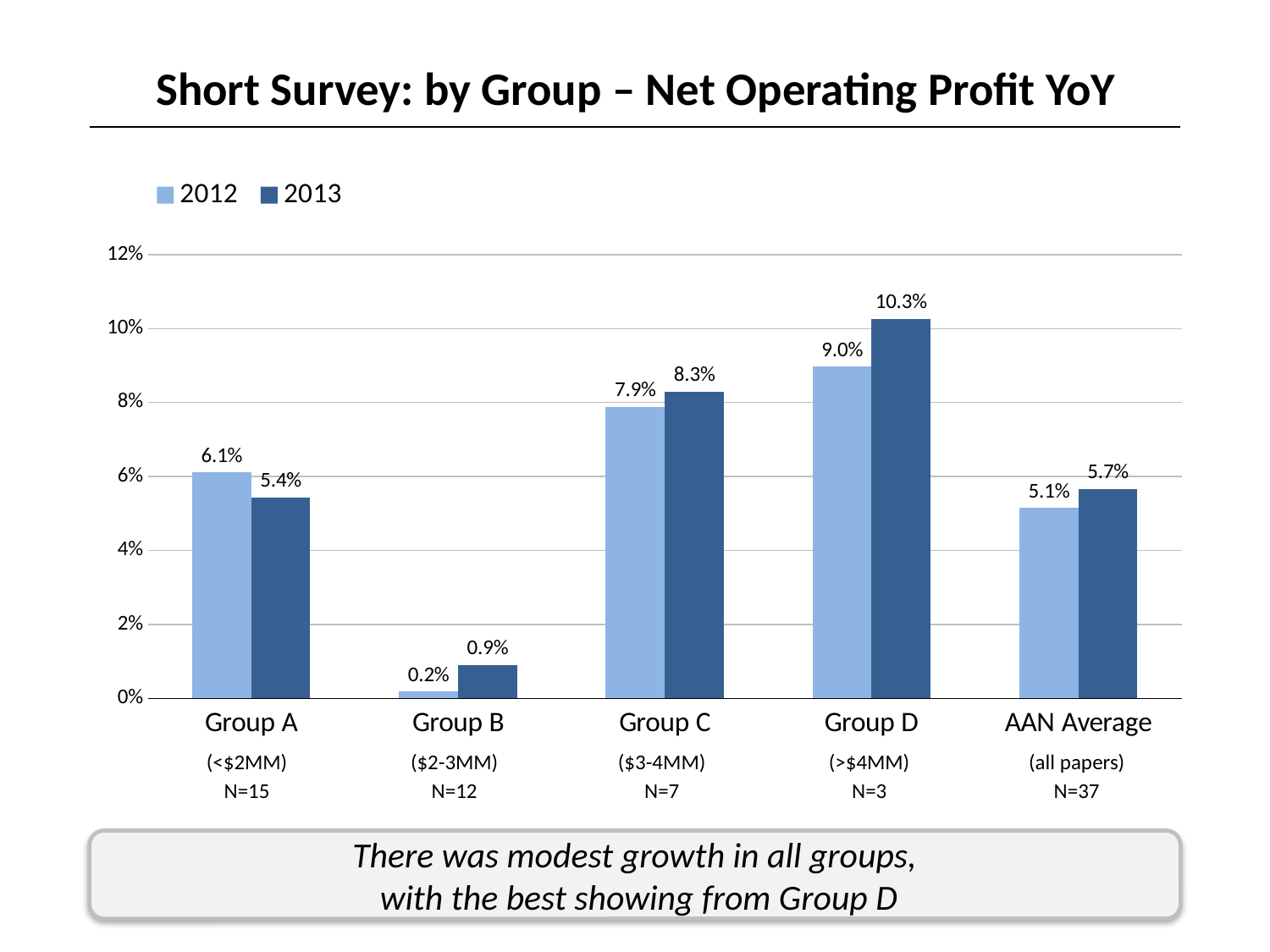
Is the 2012 value for Group D greater or less than 8%? greater What is the 2013 value for Group D? 10.3% How many series does the legend list? 2 Which group has the highest 2013 value? Group D Which is larger for Group A, the 2012 value or the 2013 value? 2012 What is the 2012 value for Group B? 0.2% What kind of chart is shown on the slide? Bar chart Which group has the lowest 2012 value? Group B What is the difference between the 2013 and 2012 values for Group C? 0.4% What is the 2013 value for AAN Average? 5.7% How many groups are shown on the x axis? 5 What is the title of the slide? Short Survey: by Group – Net Operating Profit YoY